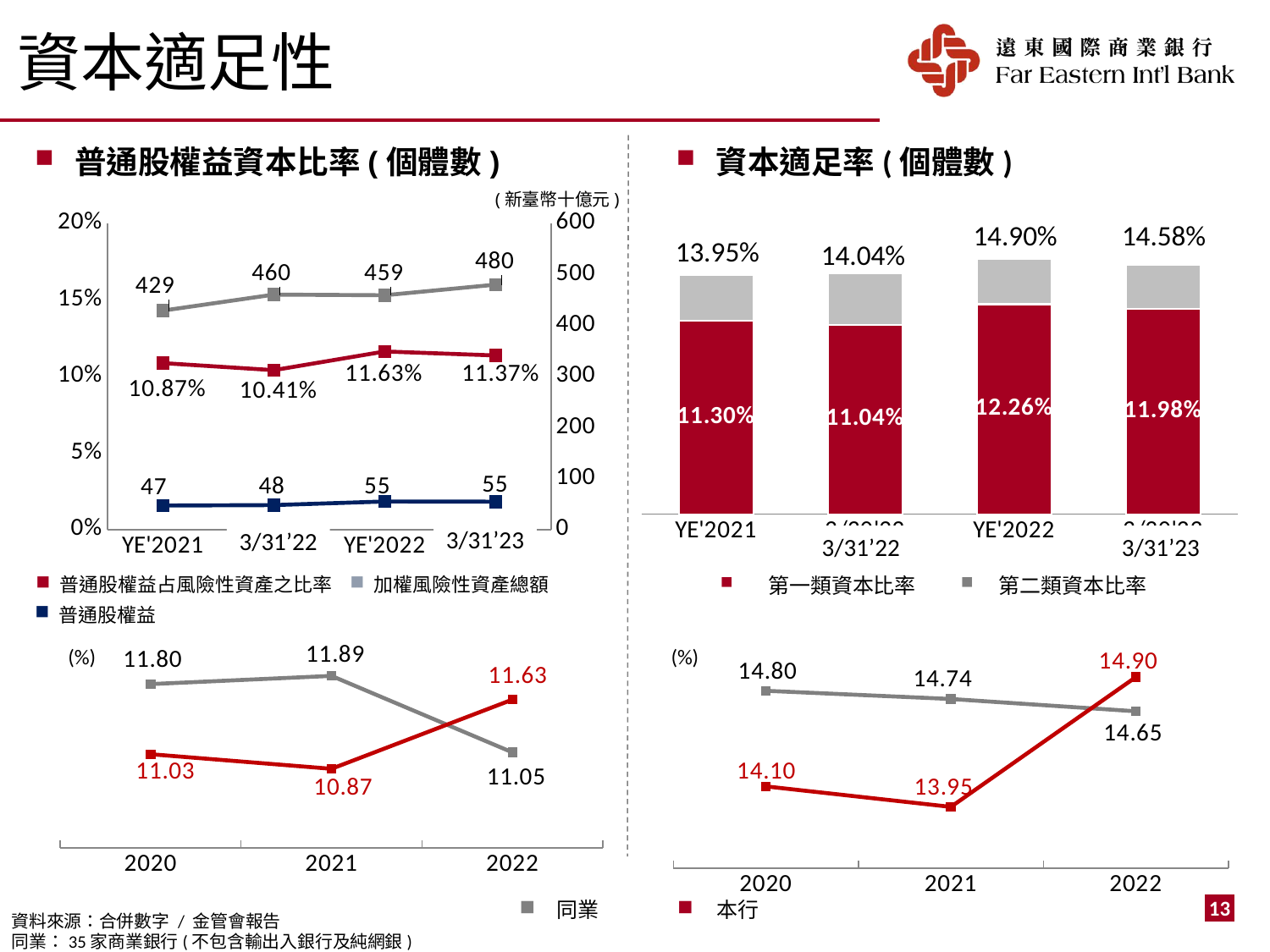
In the top-right chart titled 資本適足率 (個體數), which period has the highest total capital adequacy ratio? YE'2022 In the bottom-left line chart, what is the value of the red 本行 line in 2022? 11.63 In the top-left chart titled 普通股權益資本比率 (個體數), what is the difference between the 普通股權益 values at YE'2022 and YE'2021? 8 In the top-left chart titled 普通股權益資本比率 (個體數), what is the value of 加權風險性資產總額 at 3/31'23? 480 In the top-left chart titled 普通股權益資本比率 (個體數), what is the value of 普通股權益占風險性資產之比率 at YE'2022? 11.63% In the top-right chart titled 資本適足率 (個體數), what is the 第一類資本比率 at YE'2022? 12.26% In the bottom-left line chart, which is larger in 2021: the grey 同業 value or the red 本行 value? 同業 In the top-right chart titled 資本適足率 (個體數), what is the total of the stacked bar at 3/31'23? 14.58% In the top-left chart titled 普通股權益資本比率 (個體數), how many series does the legend list? 3 What kind of chart is the top-right chart titled 資本適足率 (個體數)? Stacked bar chart In the bottom-right line chart, does the grey 同業 line rise or fall from 2020 to 2022? Fall In the top-left chart titled 普通股權益資本比率 (個體數), at which period is 普通股權益占風險性資產之比率 lowest? 3/31'22